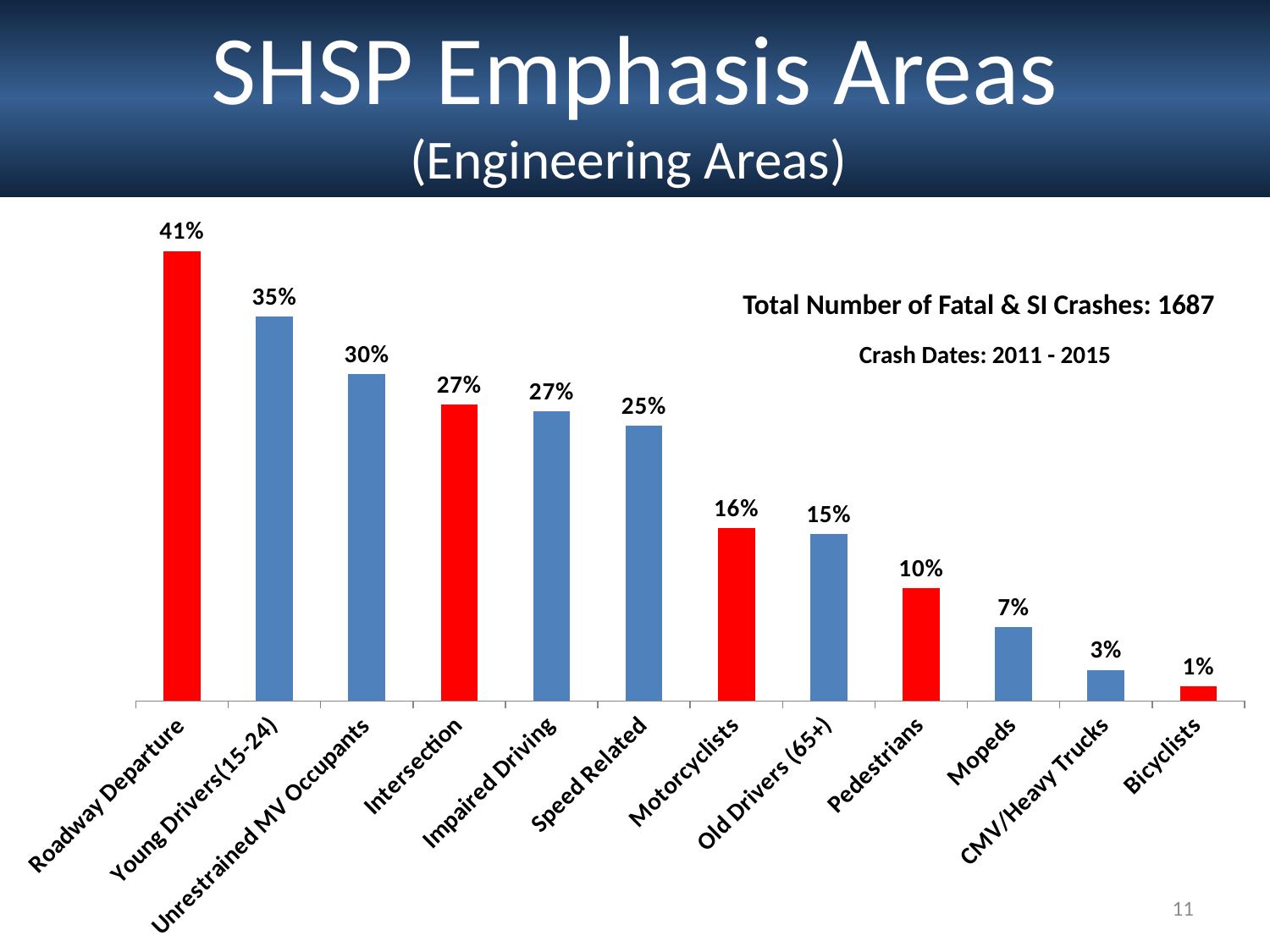
Which category has the lowest value? Bicyclists What is the value for Roadway Departure? 41% Which category has the highest value? Roadway Departure What kind of chart is shown on the slide? Bar chart What is the difference between the values for Young Drivers(15-24) and Speed Related? 10% Which is larger, the value for Motorcyclists or the value for Old Drivers (65+)? Motorcyclists What is the value for Pedestrians? 10% What is the value for CMV/Heavy Trucks? 3% What is the value for Unrestrained MV Occupants? 30% What total number of fatal & SI crashes is stated on the slide? 1687 How many categories are shown on the chart? 12 Do the values rise or fall from left to right along the x axis? Fall